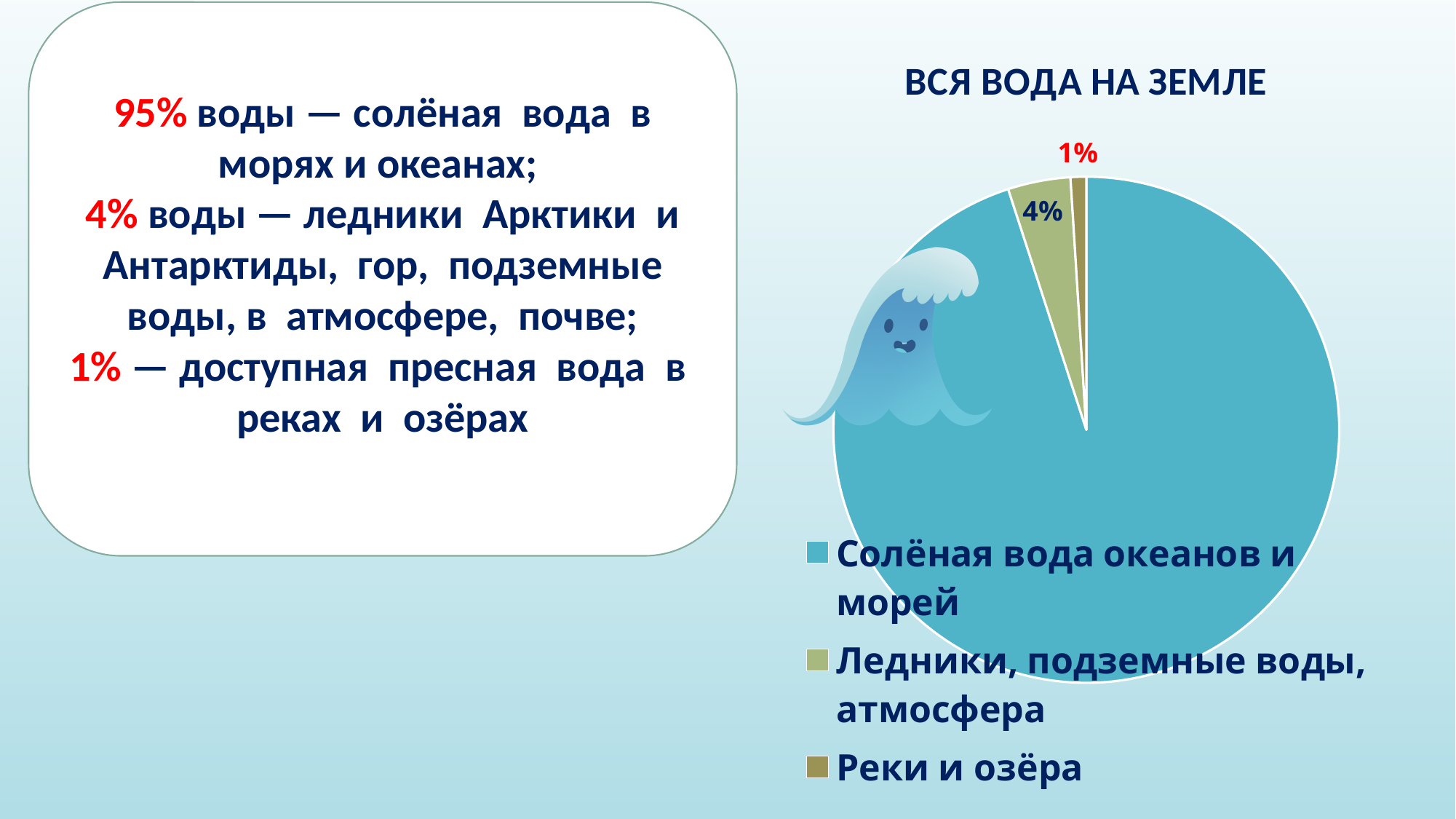
How many entries does the chart legend list? 3 How many slices does the pie chart have? 3 What percentage is shown for the slice 'Реки и озёра'? 1% What kind of chart is shown on the slide? pie chart Which category has the smallest slice of the pie? Реки и озёра What is the difference between the 'Ледники, подземные воды, атмосфера' slice and the 'Реки и озёра' slice? 3% What is the title of the chart? ВСЯ ВОДА НА ЗЕМЛЕ What percentage is shown for the slice 'Ледники, подземные воды, атмосфера'? 4% What colour is the 'Солёная вода океанов и морей' slice in the pie chart? blue (teal) Which slice is larger: 'Ледники, подземные воды, атмосфера' or 'Реки и озёра'? Ледники, подземные воды, атмосфера According to the slide, what share of all water on Earth is salt water of seas and oceans? 95% Which category has the largest slice of the pie? Солёная вода океанов и морей